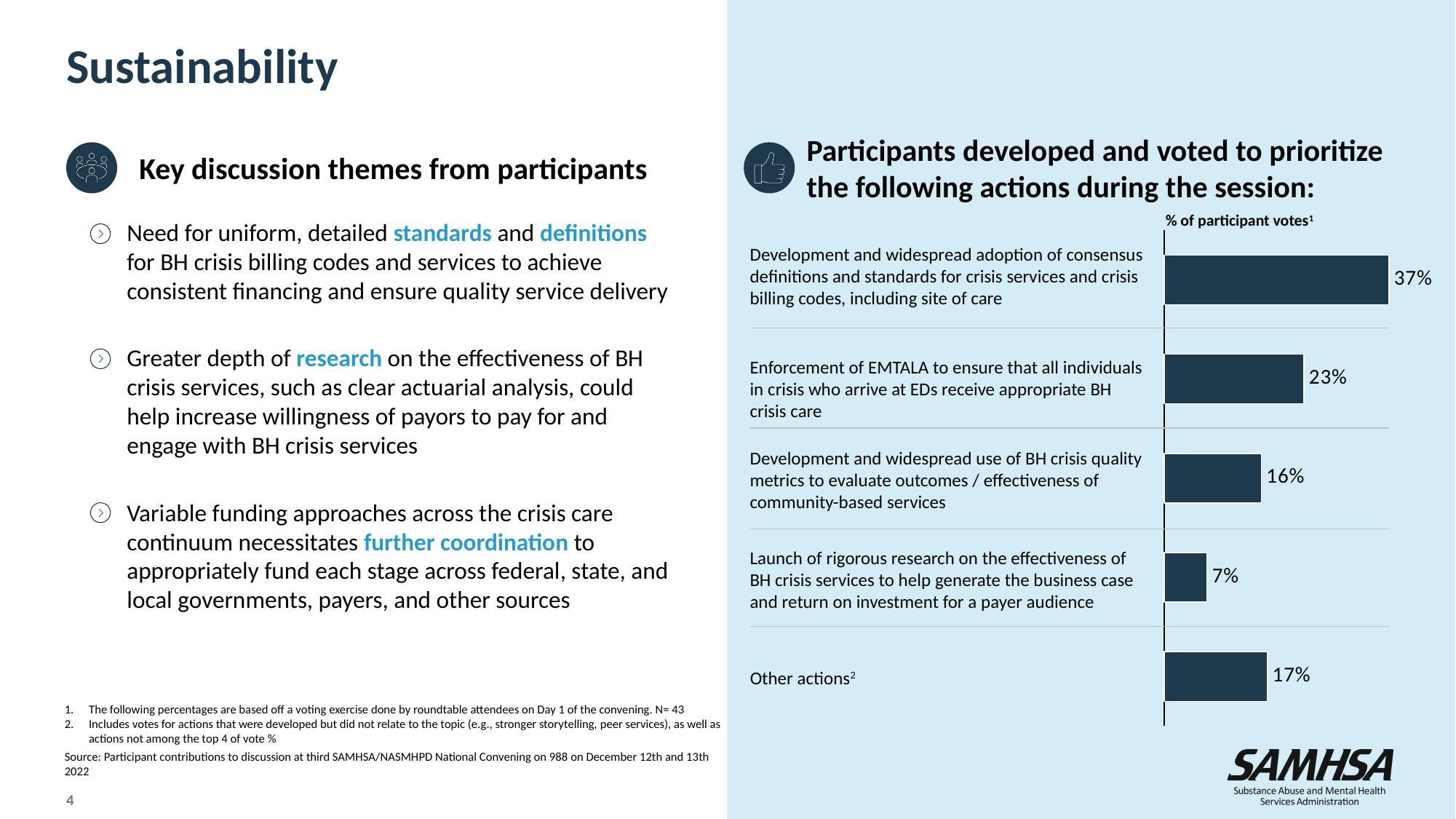
What is the axis label shown above the bars in the chart? % of participant votes What type of chart is used to show the percentage of participant votes? Bar chart Which action received the lowest percentage of participant votes? Launch of rigorous research on the effectiveness of BH crisis services to help generate the business case and return on investment for a payer audience What percentage of participant votes went to 'Other actions'? 17% Which action received the highest percentage of participant votes? Development and widespread adoption of consensus definitions and standards for crisis services and crisis billing codes, including site of care Which received a larger share of participant votes: 'Other actions' or the BH crisis quality metrics action? Other actions What percentage of participant votes did the action on development and widespread use of BH crisis quality metrics receive? 16% According to the footnote, how many attendees participated in the voting exercise (N)? 43 What is the difference in percentage of participant votes between the consensus definitions and standards action and the EMTALA enforcement action? 14% What is the difference in percentage of participant votes between the BH crisis quality metrics action and the rigorous research action? 9% How many bars are shown in the chart? 5 What percentage of participant votes did the action on enforcement of EMTALA receive? 23%